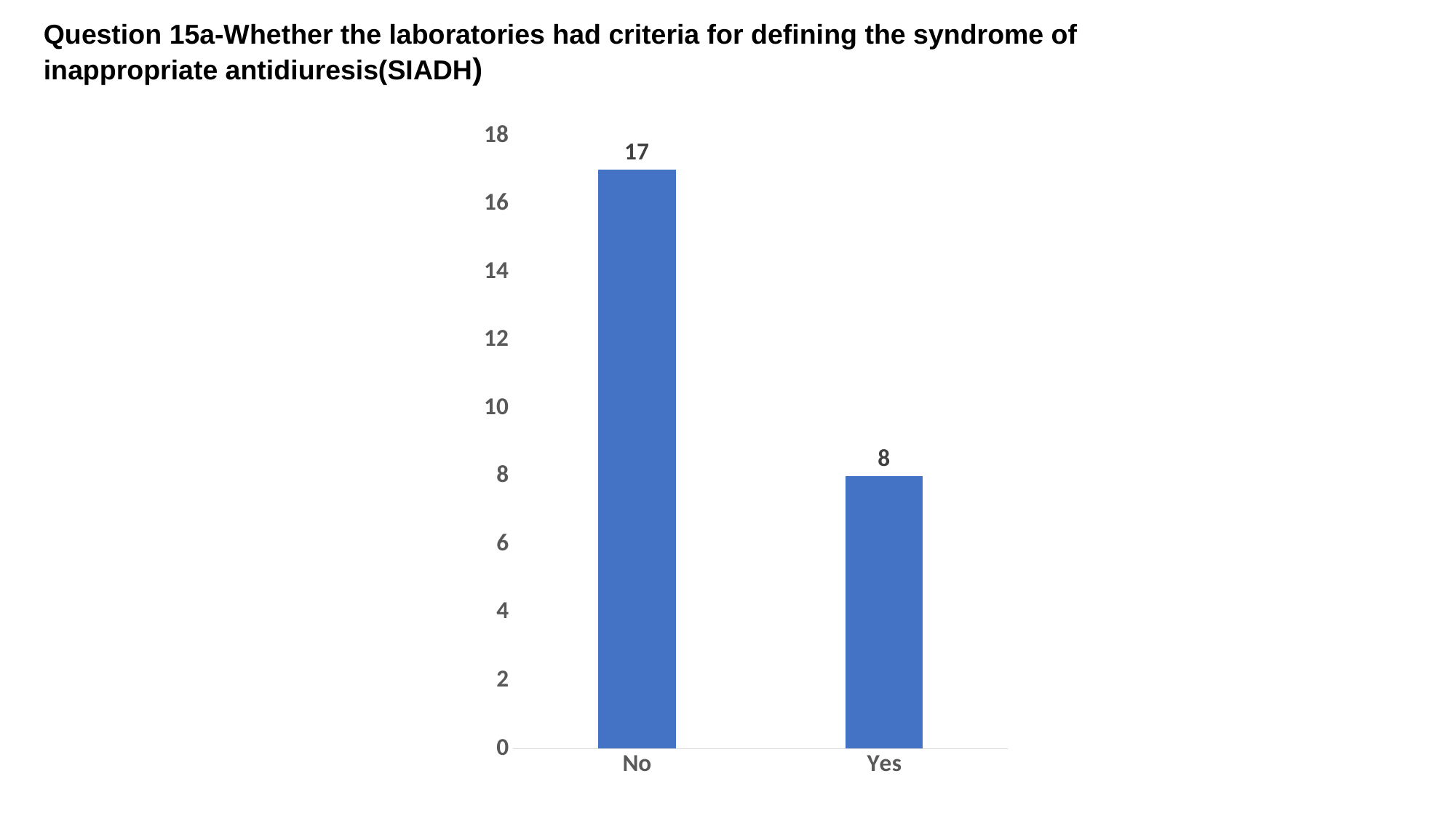
Which category has the lowest value? Yes What is the value for No? 17 What is the difference between the values for No and Yes? 9 What kind of chart is shown on the slide? bar chart What is the total of the values for No and Yes? 25 What is the value for Yes? 8 What is the highest value shown on the y axis? 18 Which is larger, the value for No or the value for Yes? No Is the value for No greater or less than 16? greater Is the value for Yes greater or less than 10? less How many categories are shown on the x axis? 2 Which category has the highest value? No